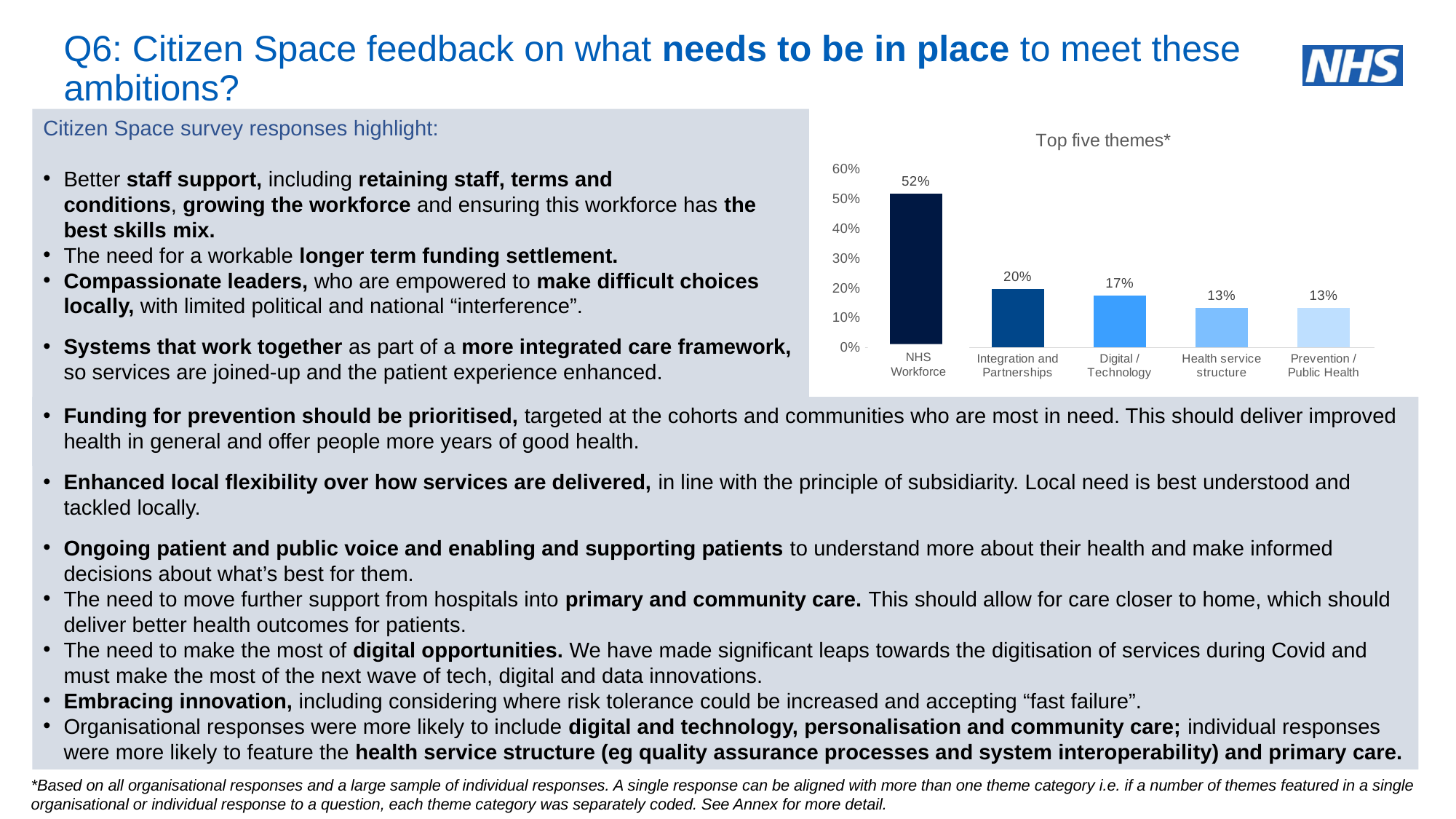
What is the value for Digital / Technology? 17% What is the difference between the values for Integration and Partnerships and Digital / Technology? 3% Is the value for NHS Workforce greater or less than 50%? greater What is the value for Health service structure? 13% How many themes are shown in the chart? 5 Which is larger, the value for Integration and Partnerships or the value for Prevention / Public Health? Integration and Partnerships What is the value for Integration and Partnerships? 20% What is the value for NHS Workforce in the Top five themes chart? 52% What is the difference between the values for NHS Workforce and Integration and Partnerships? 32% What is the title of the chart? Top five themes* Which theme has the highest value in the chart? NHS Workforce What kind of chart is shown on the slide? Bar chart